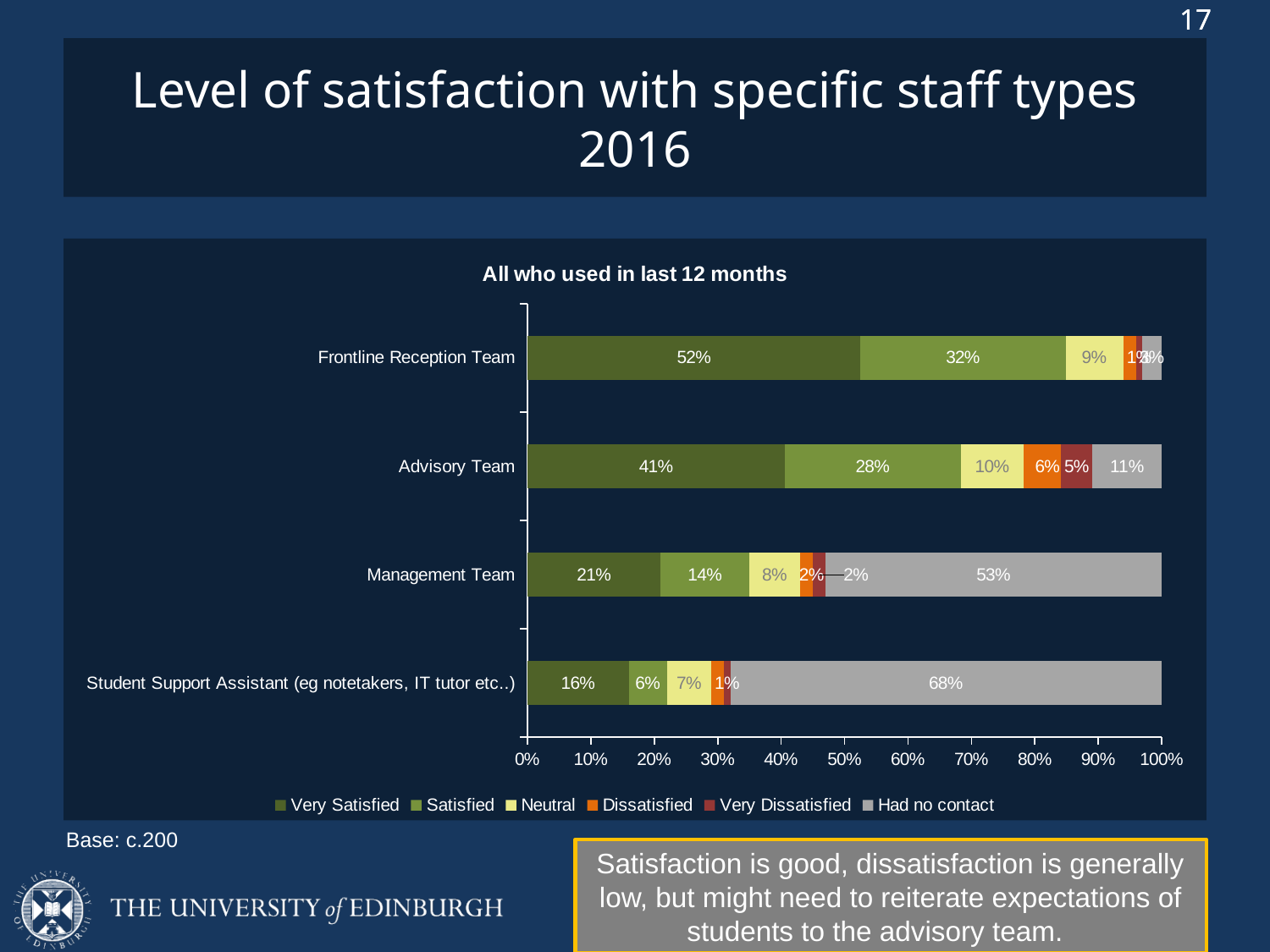
What percentage of respondents were Very Satisfied with the Frontline Reception Team? 52% What percentage of respondents were Dissatisfied with the Advisory Team? 6% What percentage of respondents had no contact with the Management Team? 53% Which staff type has the lowest Very Satisfied percentage? Student Support Assistant (eg notetakers, IT tutor etc..) How many series does the legend list? 6 How many staff types (categories) are shown in the chart? 4 What type of chart is shown on the slide? Stacked bar chart What is the difference between the Very Satisfied percentages for the Frontline Reception Team and the Advisory Team? 11% What percentage of respondents had no contact with the Student Support Assistant? 68% What percentage of respondents were Satisfied with the Advisory Team? 28% What is the title shown above the chart? All who used in last 12 months Which staff type has the highest Very Satisfied percentage? Frontline Reception Team